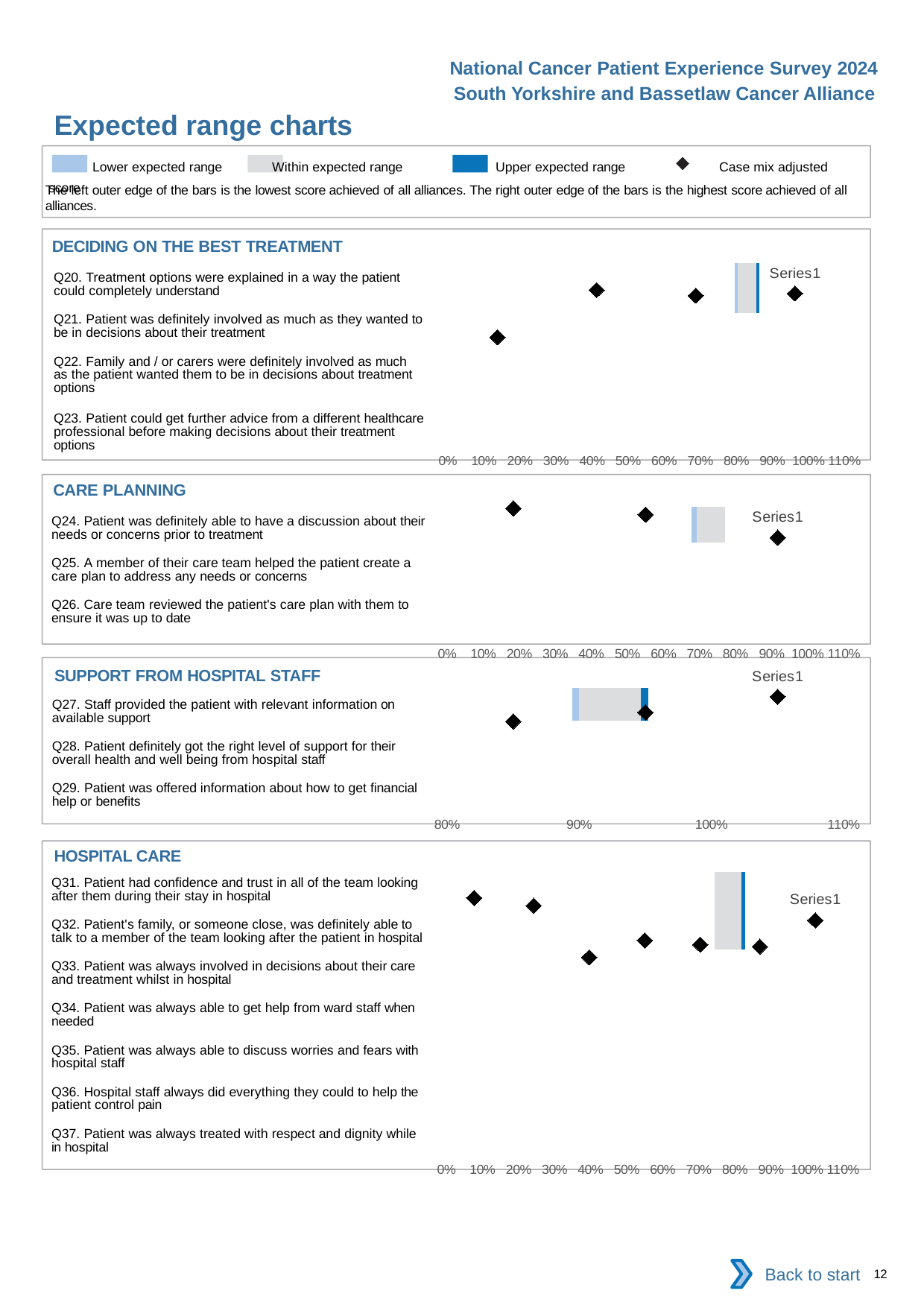
How many questions are listed in the Care Planning section? 3 How many chart sections are shown on the slide? 4 How many questions are listed in the Deciding on the Best Treatment section? 4 What is the lowest axis tick shown on the Support from Hospital Staff chart? 80% In the Deciding on the Best Treatment chart, is the leftmost diamond marker greater or less than 30%? less In the Care Planning chart, how many series does the legend list? 1 What is the name of the series shown in the legend of the Deciding on the Best Treatment chart? Series1 In the Hospital Care chart, is the leftmost diamond marker greater or less than 20%? less